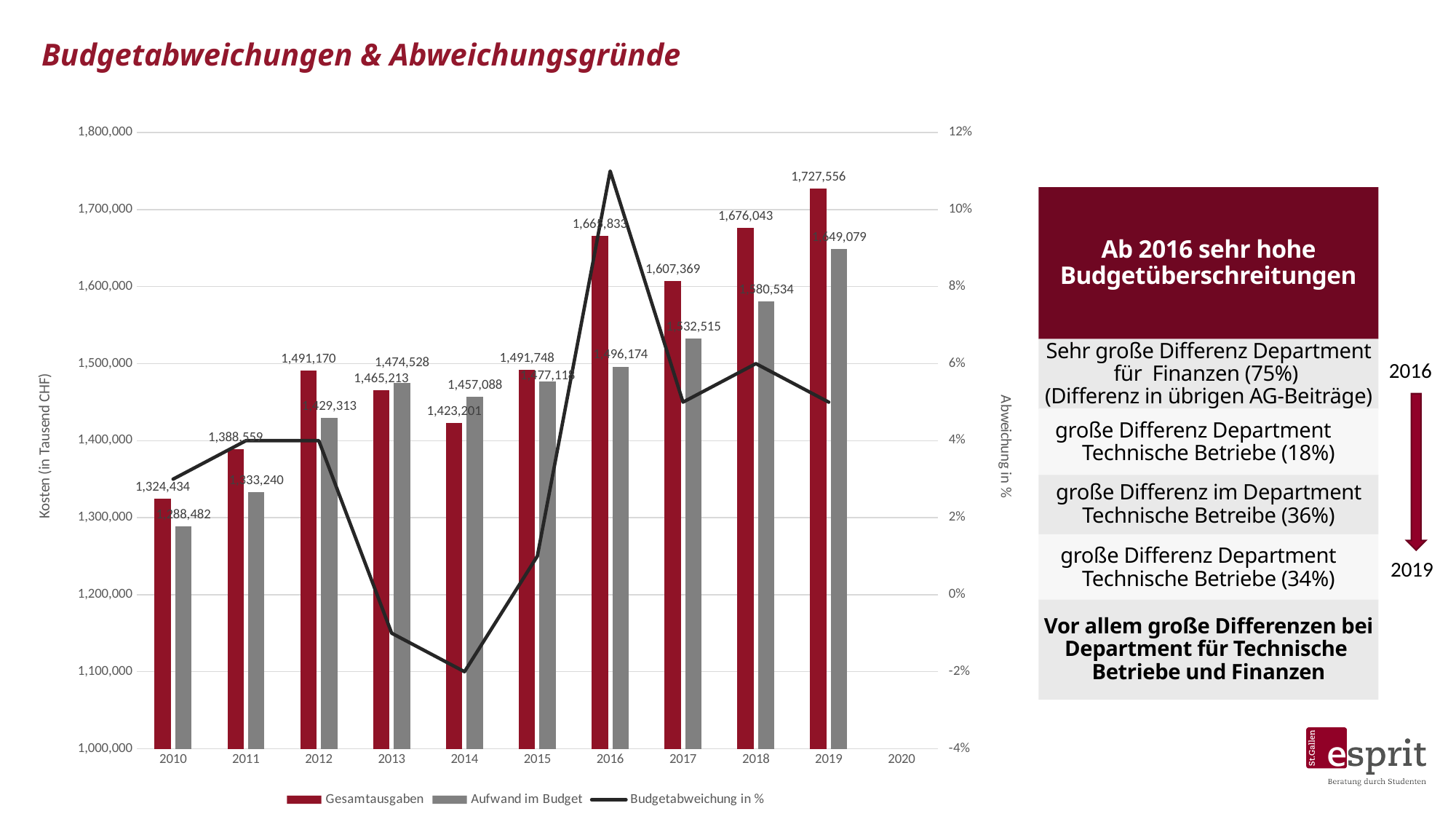
What is the value of Aufwand im Budget for 2010? 1,288,482 Is the Budgetabweichung in % for 2016 greater or less than 10%? greater Do the Gesamtausgaben rise or fall from 2010 to 2012? rise For how many years are bars plotted in the chart? 10 What is the value of Gesamtausgaben for 2014? 1,423,201 What is the value of Gesamtausgaben for 2019? 1,727,556 How many series does the legend list? 3 Is the Budgetabweichung in % for 2014 greater or less than 0%? less In 2013, which is larger: Gesamtausgaben or Aufwand im Budget? Aufwand im Budget In which year are the Gesamtausgaben highest? 2019 What is the difference between Gesamtausgaben and Aufwand im Budget in 2010? 35,952 In which year are the Gesamtausgaben lowest? 2010